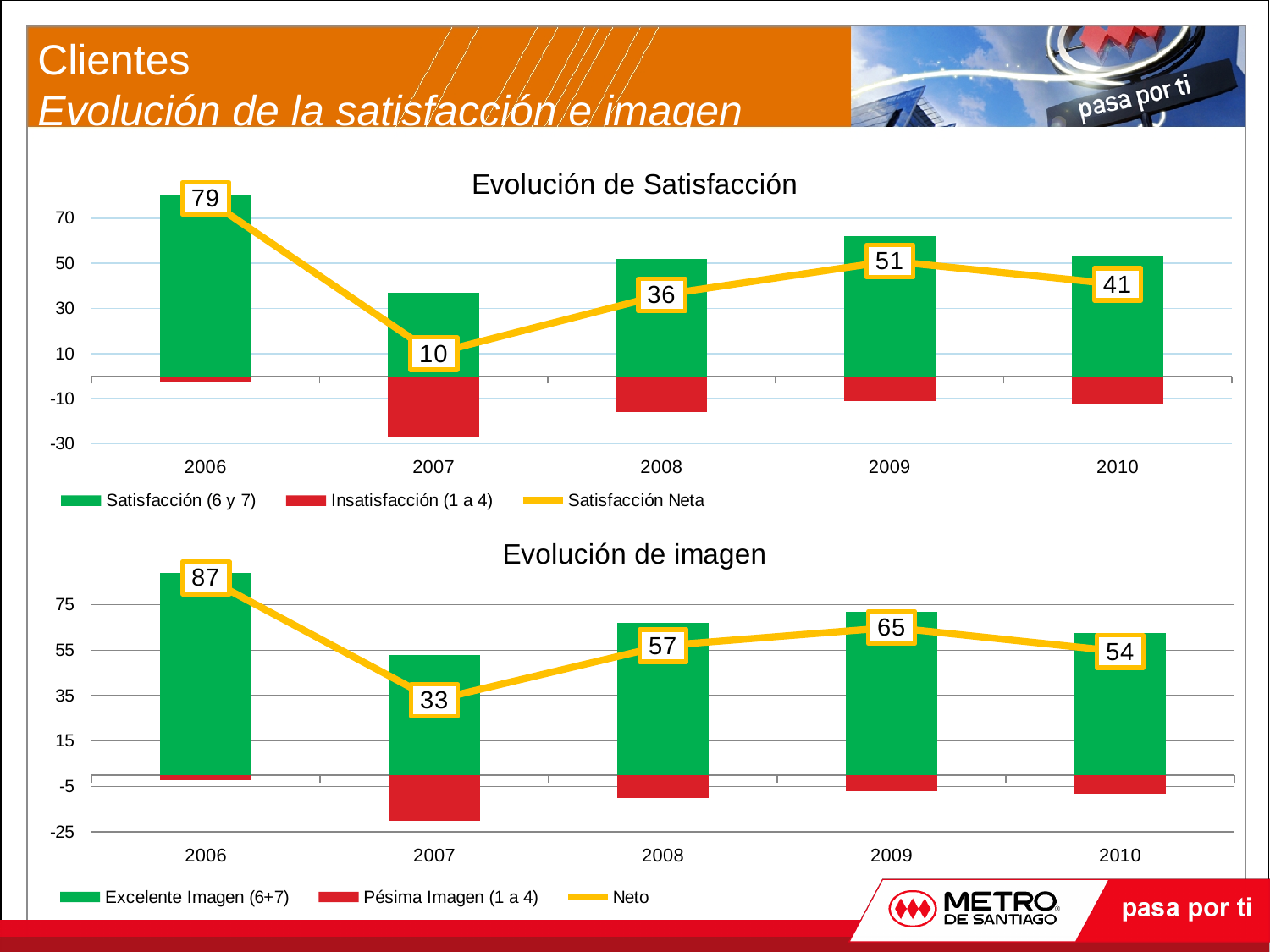
In the 'Evolución de Satisfacción' chart, what is the Satisfacción Neta value for 2006? 79 In the 'Evolución de Satisfacción' chart, what is the difference between the Satisfacción Neta values for 2006 and 2007? 69 In the 'Evolución de Satisfacción' chart, is the Insatisfacción (1 a 4) bar for 2007 greater or less than -10? less In the 'Evolución de imagen' chart, what is the difference between the Neto values for 2009 and 2010? 11 In the 'Evolución de imagen' chart, which year has the highest Neto value? 2006 How many series does the legend of the 'Evolución de imagen' chart list? 3 In the 'Evolución de Satisfacción' chart, which year has the lowest Satisfacción Neta value? 2007 How many years are shown on the x axis of the 'Evolución de Satisfacción' chart? 5 In the 'Evolución de Satisfacción' chart, what is the Satisfacción Neta value for 2009? 51 In the 'Evolución de Satisfacción' chart, is the Satisfacción Neta value for 2010 larger or smaller than the value for 2009? smaller In the 'Evolución de imagen' chart, is the Excelente Imagen (6+7) bar for 2006 greater or less than 75? greater In the 'Evolución de imagen' chart, what is the Neto value for 2008? 57